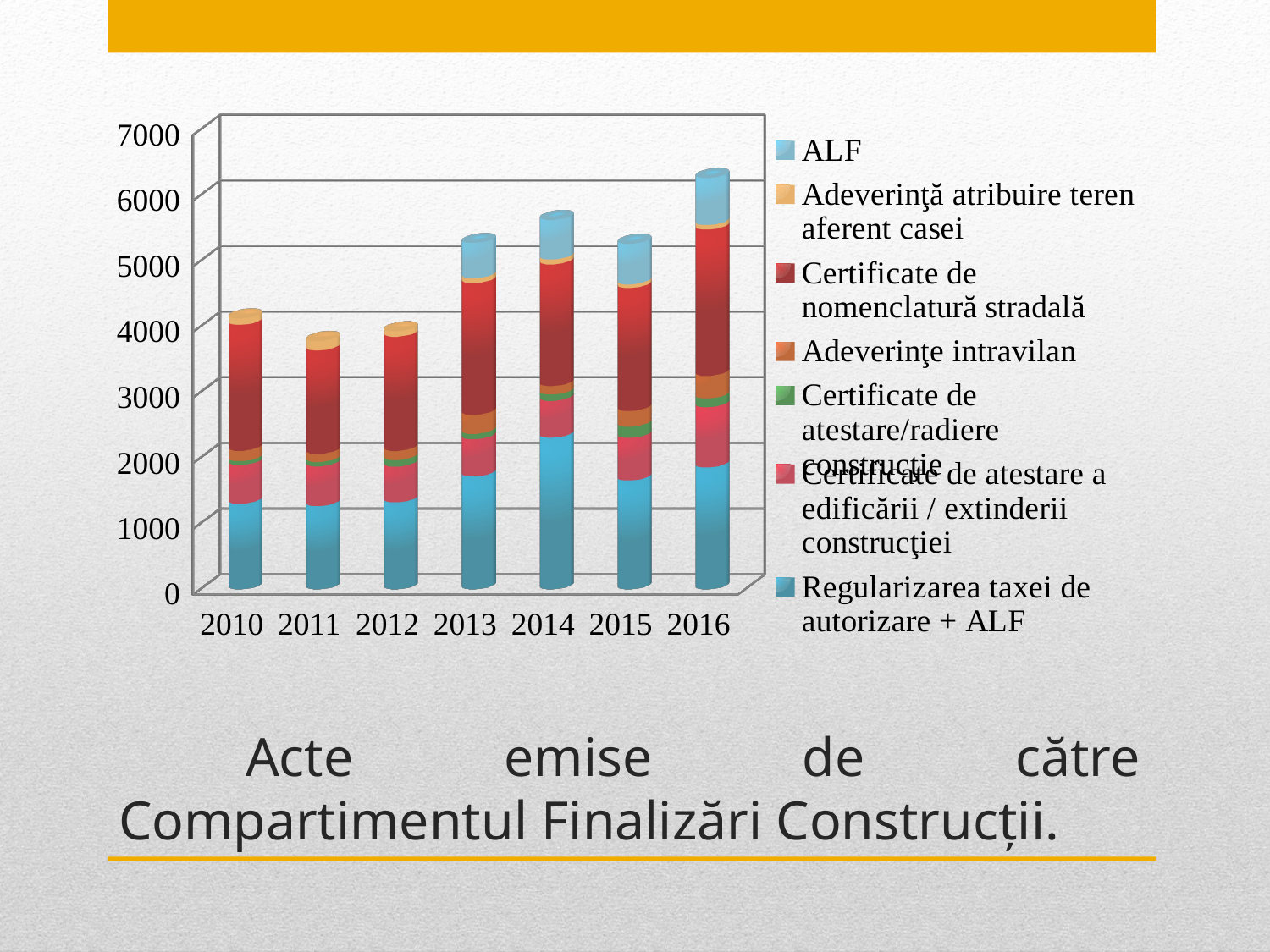
Which series forms the bottom segment of each stacked bar? Regularizarea taxei de autorizare + ALF How many years are shown on the x axis of the chart? 7 Which year has the tallest stacked bar? 2016 Is the total stacked value for 2014 greater or less than 5000? greater Is the total stacked value for 2010 greater or less than 5000? less Which year has the larger total stacked bar, 2014 or 2015? 2014 Which year has the larger total stacked bar, 2010 or 2016? 2016 Which series is listed first in the chart's legend? ALF Is the total stacked value for 2016 greater or less than 6000? greater How many series does the chart's legend list? 7 What kind of chart is shown on the slide? Stacked bar chart